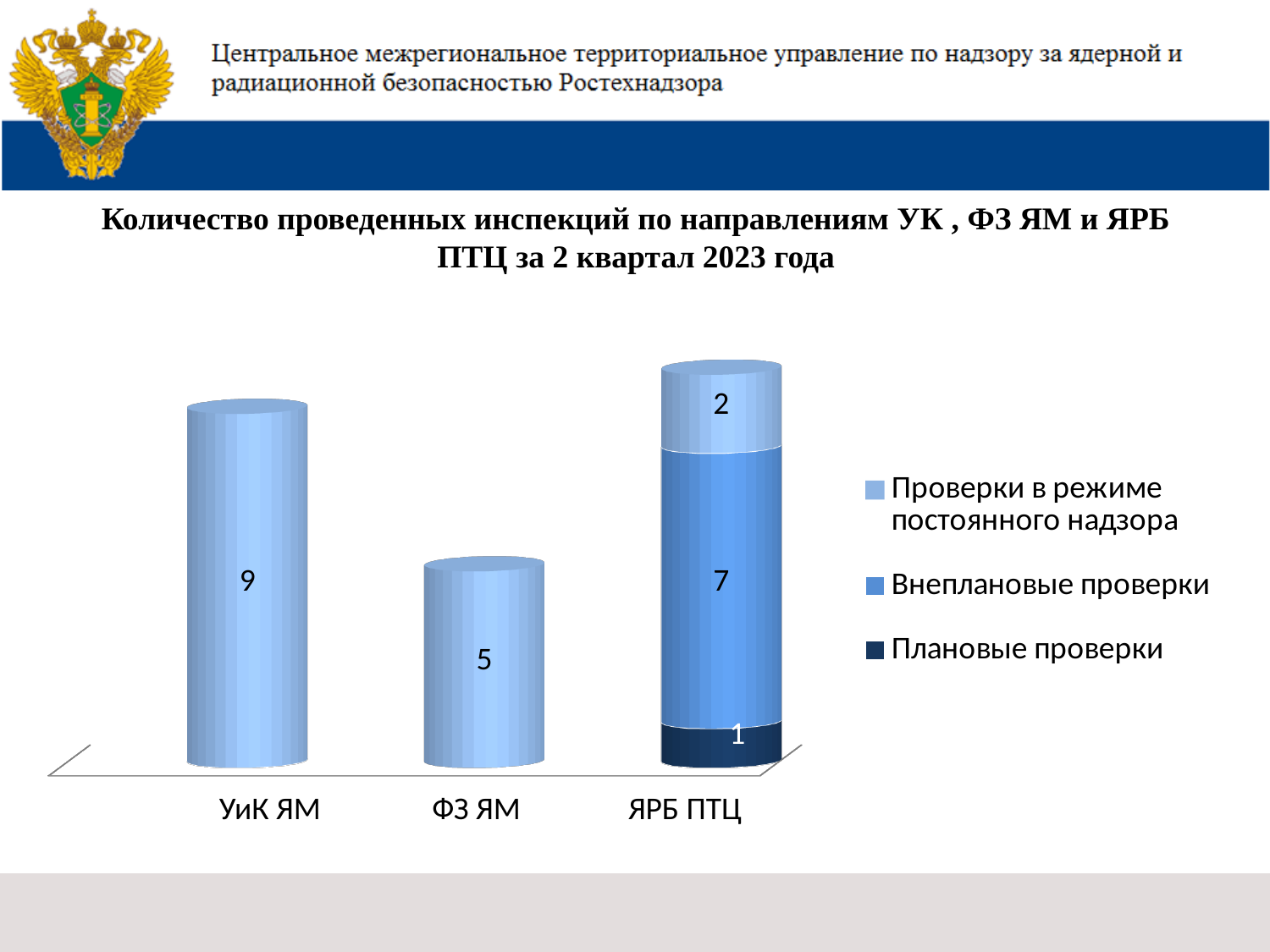
What is the value for УиК ЯМ in the series Проверки в режиме постоянного надзора? 9 What is the difference between the values for УиК ЯМ and ФЗ ЯМ in the series Проверки в режиме постоянного надзора? 4 What is the total of the stacked bar for ЯРБ ПТЦ? 10 What is the value for ФЗ ЯМ in the series Проверки в режиме постоянного надзора? 5 What kind of chart is shown on the slide? Stacked bar chart What is the value of Плановые проверки for ЯРБ ПТЦ? 1 What is the value of Внеплановые проверки for ЯРБ ПТЦ? 7 How many categories are shown on the x axis of the chart? 3 Which is larger for ЯРБ ПТЦ: Внеплановые проверки or Плановые проверки? Внеплановые проверки How many series does the chart legend list? 3 Which category has the lowest total number of inspections? ФЗ ЯМ What is the value of Проверки в режиме постоянного надзора for ЯРБ ПТЦ? 2